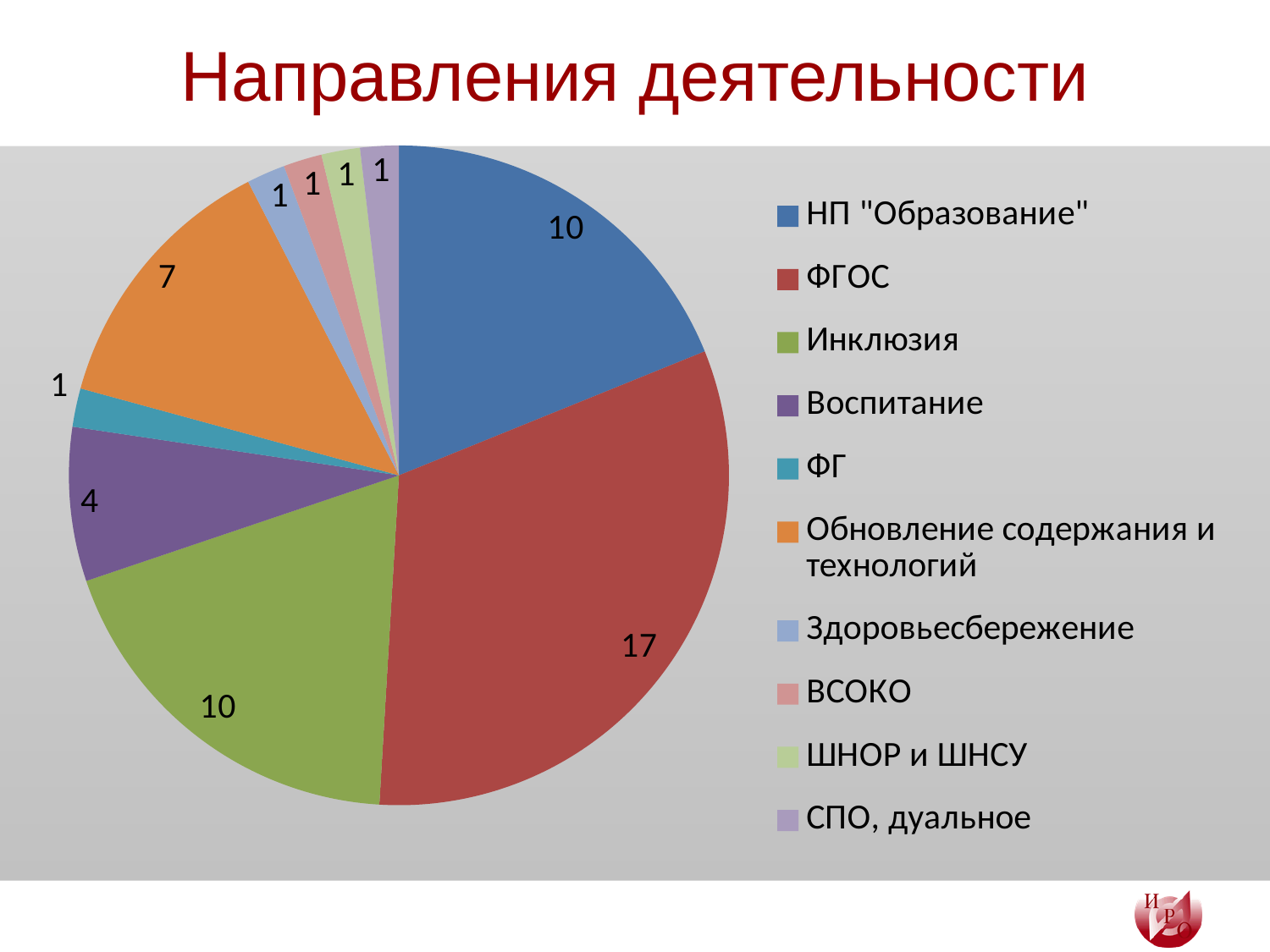
What is the title of the chart? Направления деятельности What colour is the slice for ФГОС? red What is the value for Инклюзия? 10 What is the value for ФГОС? 17 How many categories have a value of 1? 5 Which category has the largest slice? ФГОС How many categories does the legend list? 10 What is the difference between the values for ФГОС and НП "Образование"? 7 What is the value for Воспитание? 4 What is the value for Обновление содержания и технологий? 7 Which is larger, the value for Воспитание or the value for Обновление содержания и технологий? Обновление содержания и технологий What kind of chart is shown on the slide? pie chart